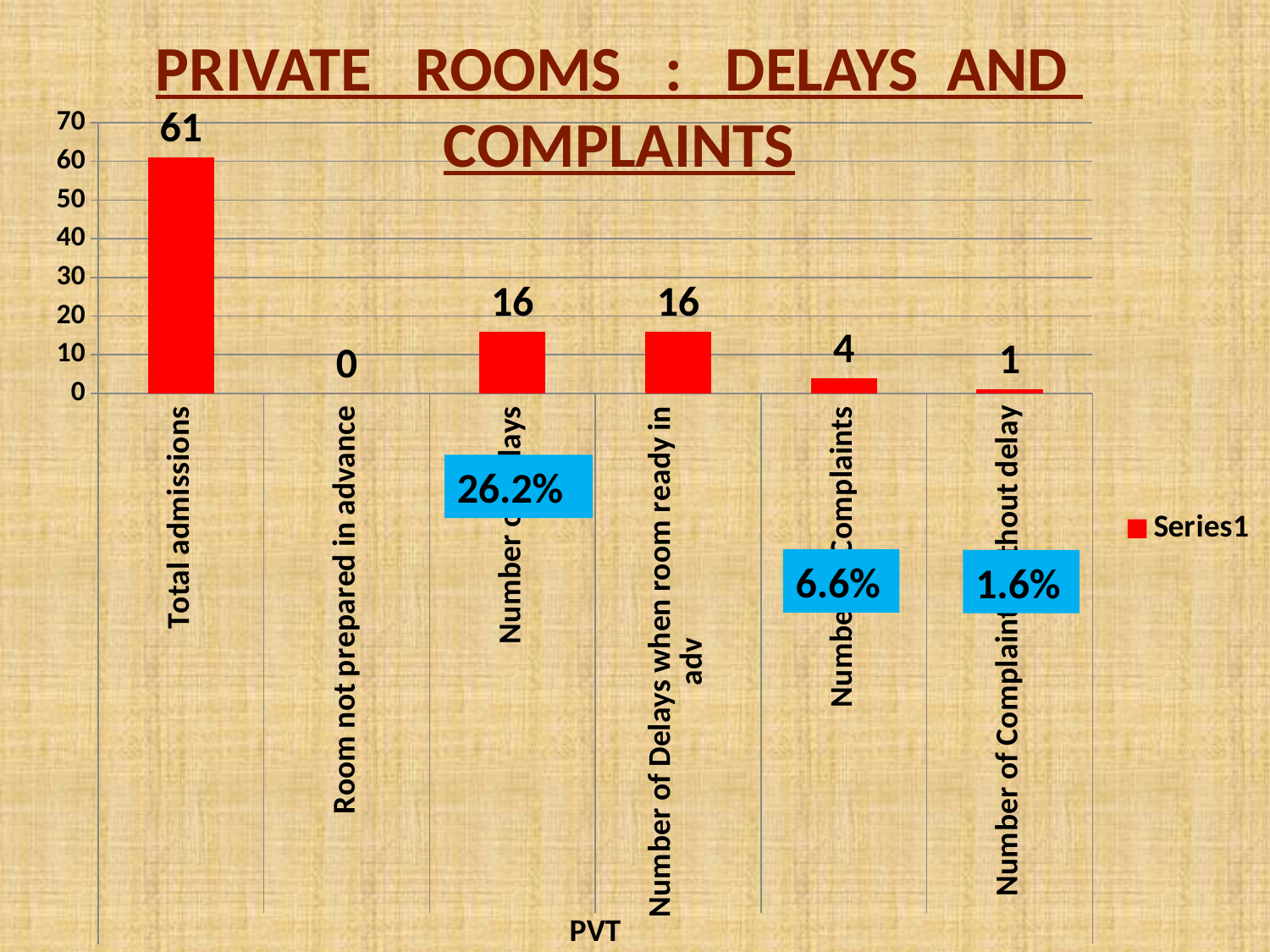
Which category has the lowest value? Room not prepared in advance What is the value for Room not prepared in advance? 0 What kind of chart is shown on the slide? Bar chart What is the title of the chart? PRIVATE ROOMS : DELAYS AND COMPLAINTS What is the value for Number of Delays when room ready in adv? 16 What is the value for Total admissions? 61 What is the value for Number of Complaints? 4 What is the value for Number of Complaints without delay? 1 Which is larger, Number of Complaints or Number of Complaints without delay? Number of Complaints How many categories are shown on the x axis? 6 Which category has the highest value? Total admissions What is the difference between Total admissions and Number of Delays when room ready in adv? 45